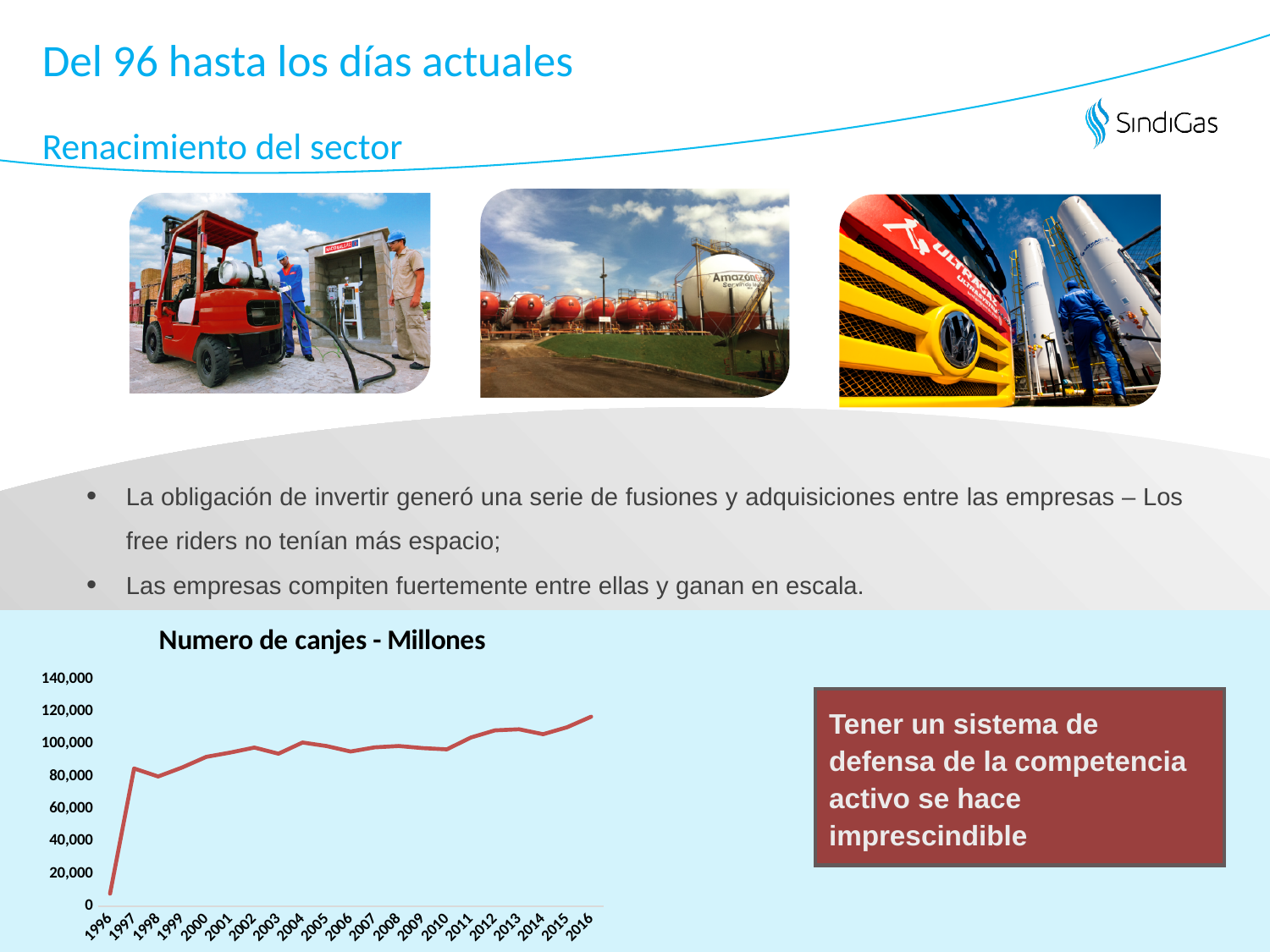
Overall, do the values rise or fall from 1996 to 2016? rise Is the value for 1998 greater or less than 100,000? less Which year has the lowest value in the chart? 1996 Is the value for 2016 greater or less than 100,000? greater How many years are plotted along the x axis of the chart? 21 What kind of chart is shown on the slide? line chart Is the value for 1996 greater or less than 20,000? less Which year has the larger value, 1997 or 2016? 2016 Which year has the highest value in the chart? 2016 What is the title of the chart on the slide? Numero de canjes - Millones